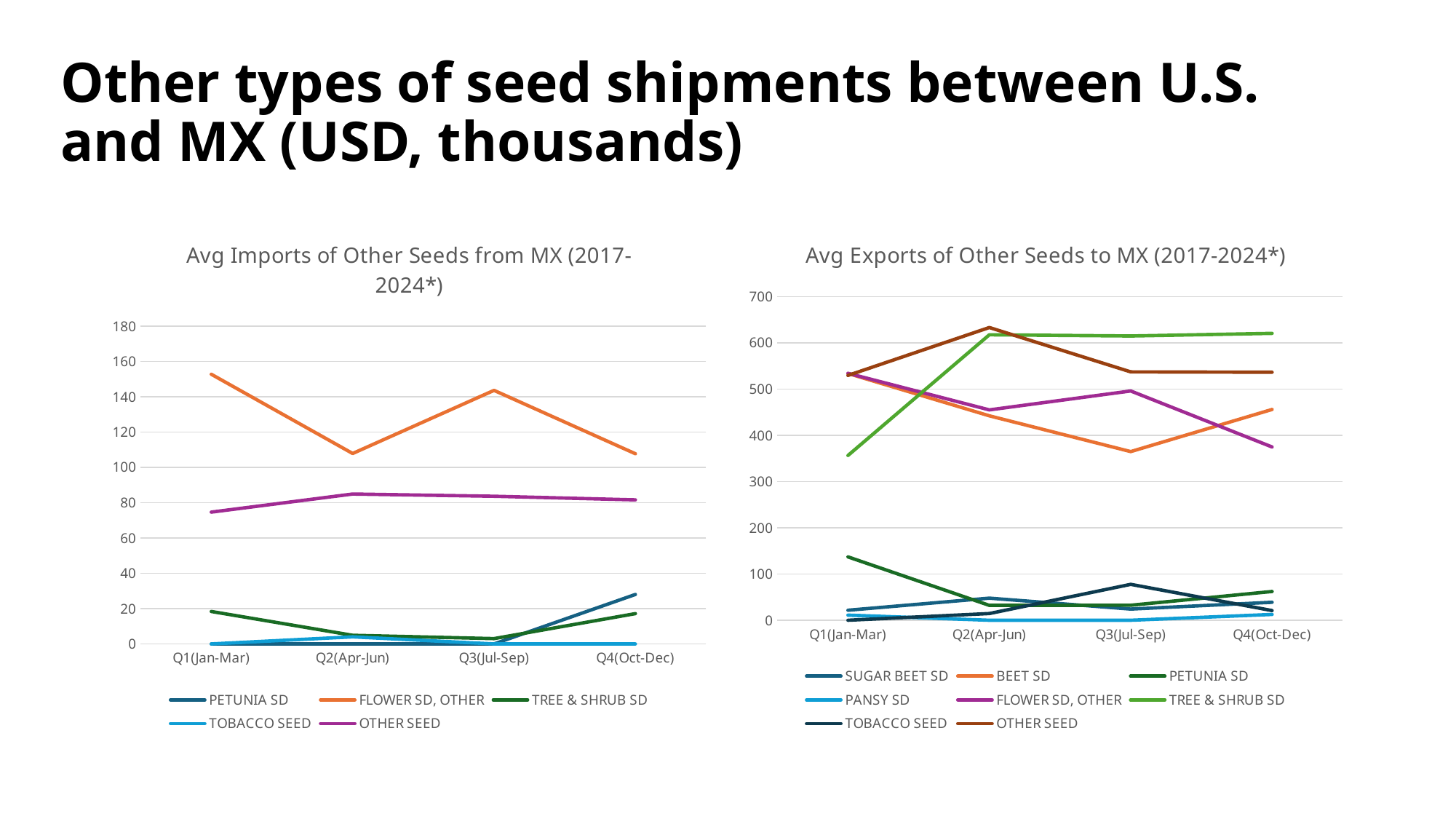
In the "Avg Exports of Other Seeds to MX (2017-2024*)" chart, does the BEET SD line rise or fall from Q1(Jan-Mar) to Q3(Jul-Sep)? Fall In the "Avg Imports of Other Seeds from MX (2017-2024*)" chart, which series has the highest value in Q3(Jul-Sep)? FLOWER SD, OTHER What is the title of the chart on the left side of the slide? Avg Imports of Other Seeds from MX (2017-2024*) In the "Avg Exports of Other Seeds to MX (2017-2024*)" chart, which series has the highest value in Q4(Oct-Dec)? TREE & SHRUB SD In the "Avg Imports of Other Seeds from MX (2017-2024*)" chart, is the value for OTHER SEED in Q2(Apr-Jun) greater or less than 80? greater In the "Avg Imports of Other Seeds from MX (2017-2024*)" chart, is the value for FLOWER SD, OTHER in Q1(Jan-Mar) greater or less than 140? greater In the "Avg Exports of Other Seeds to MX (2017-2024*)" chart, which is larger in Q3(Jul-Sep): BEET SD or FLOWER SD, OTHER? FLOWER SD, OTHER In the "Avg Exports of Other Seeds to MX (2017-2024*)" chart, is the value for TREE & SHRUB SD in Q1(Jan-Mar) greater or less than 400? less How many quarters are shown on the x axis of the "Avg Exports of Other Seeds to MX (2017-2024*)" chart? 4 How many series does the legend of the "Avg Imports of Other Seeds from MX (2017-2024*)" chart list? 5 How many series does the legend of the "Avg Exports of Other Seeds to MX (2017-2024*)" chart list? 8 What kind of chart is the "Avg Imports of Other Seeds from MX (2017-2024*)" chart? Line chart